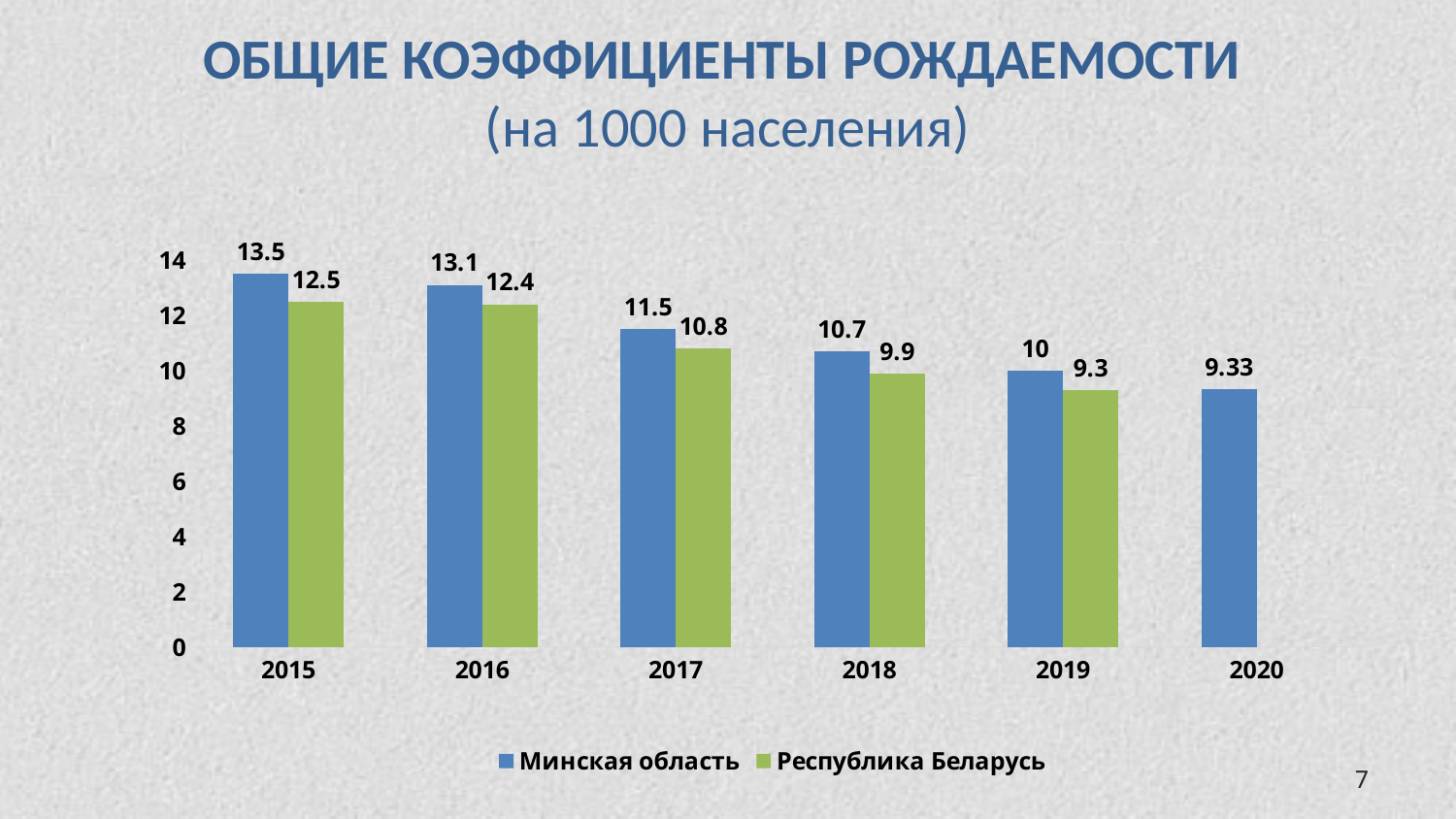
Is the value for Минская область in 2018 greater or less than 10? greater How many series does the legend list? 2 What is the difference between Минская область and Республика Беларусь in 2016? 0.7 How many years are shown on the x axis? 6 What kind of chart is shown on the slide? bar chart What is the value for Минская область in 2015? 13.5 In which year is the value for Республика Беларусь the lowest? 2019 What is the value for Минская область in 2020? 9.33 In which year is the value for Минская область the highest? 2015 Do the values for Минская область rise or fall from 2015 to 2020? fall What is the value for Республика Беларусь in 2018? 9.9 Which is larger in 2017: Минская область or Республика Беларусь? Минская область